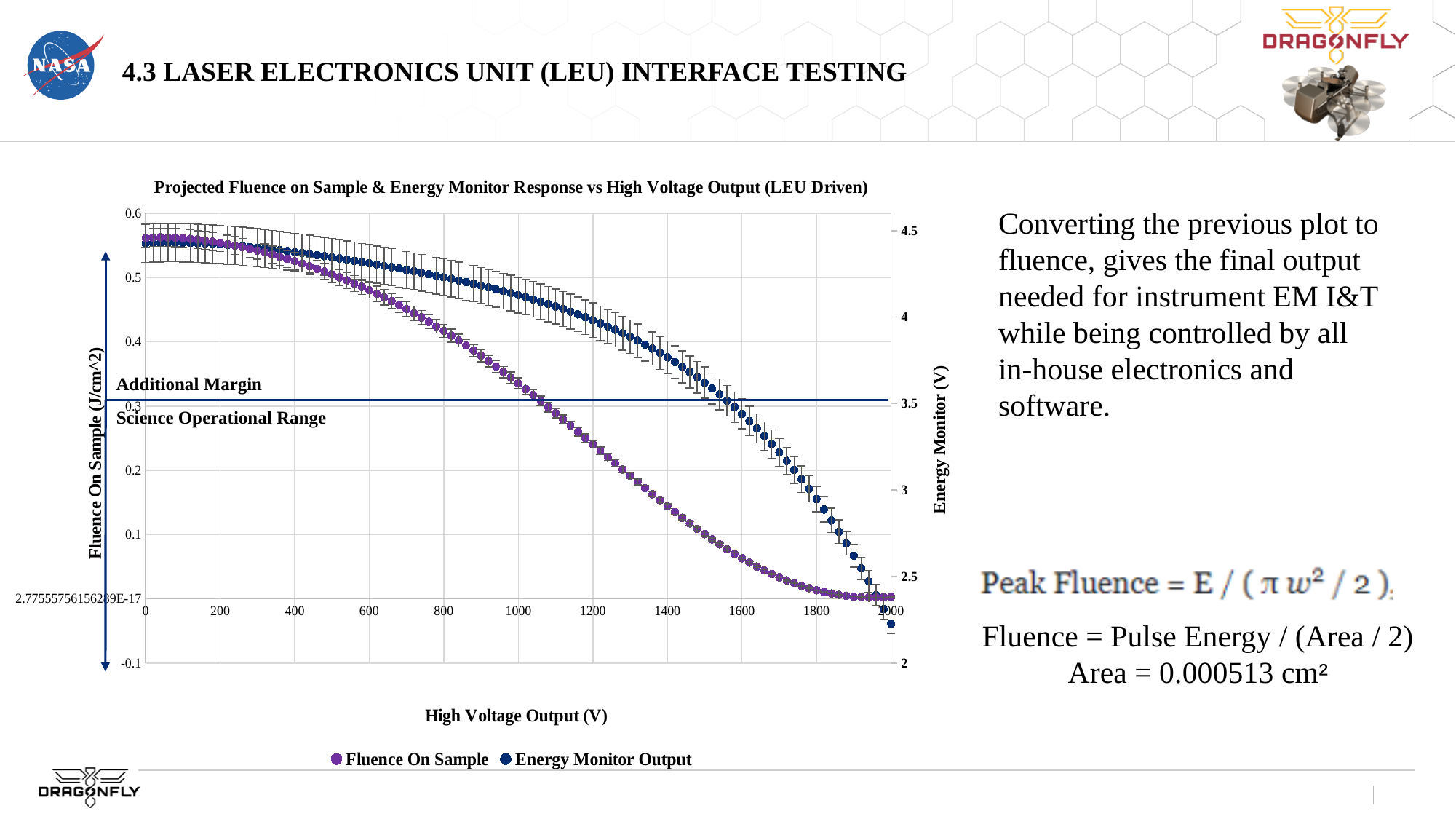
Is the Energy Monitor Output value at 600 V greater or less than 4? greater What kind of chart is shown on the slide? scatter chart Is the Energy Monitor Output value at 1400 V greater or less than 3.5? greater Is the Fluence On Sample value at 1400 V greater or less than 0.2? less Does the Energy Monitor Output series rise or fall as High Voltage Output increases? fall What is the title of the chart? Projected Fluence on Sample & Energy Monitor Response vs High Voltage Output (LEU Driven) How many series does the chart legend list? 2 What are the two series named in the chart legend? Fluence On Sample and Energy Monitor Output Does the Fluence On Sample series rise or fall as High Voltage Output increases? fall